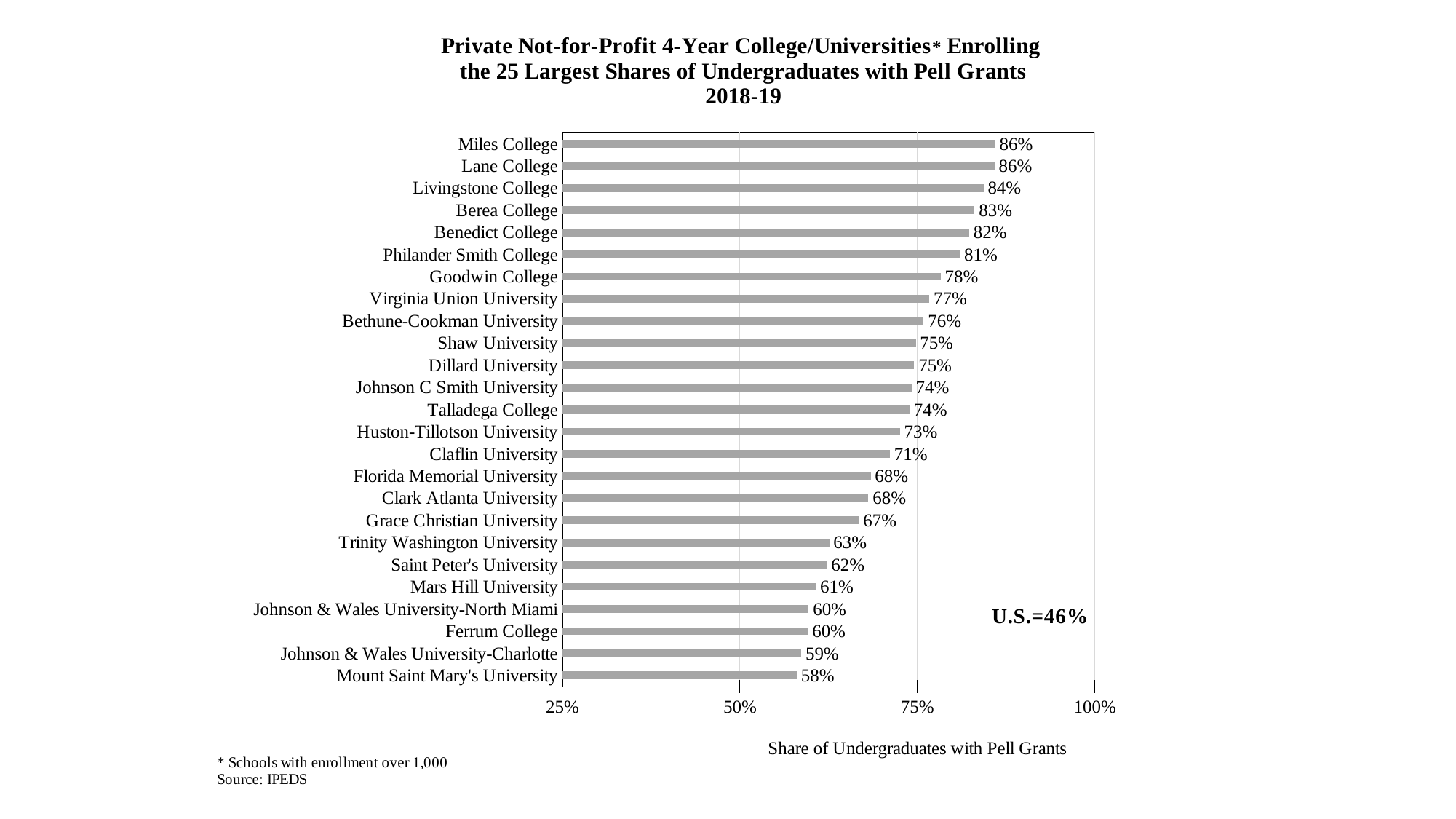
What share of undergraduates with Pell Grants is shown for Mount Saint Mary's University? 58% Which institution has the lowest share of undergraduates with Pell Grants on the chart? Mount Saint Mary's University Is the value for Philander Smith College greater or less than 75%? greater What kind of chart is shown on the slide? Bar chart What is the U.S. value noted on the chart? 46% Which has a larger share of undergraduates with Pell Grants, Benedict College or Shaw University? Benedict College How many institutions are shown on the chart? 25 What is the difference between the values for Goodwin College and Trinity Washington University? 15% Which has a larger value, Ferrum College or Grace Christian University? Grace Christian University What share of undergraduates with Pell Grants does Berea College have? 83% What is the difference between the values for Miles College and Mount Saint Mary's University? 28% What is the value shown for Claflin University? 71%